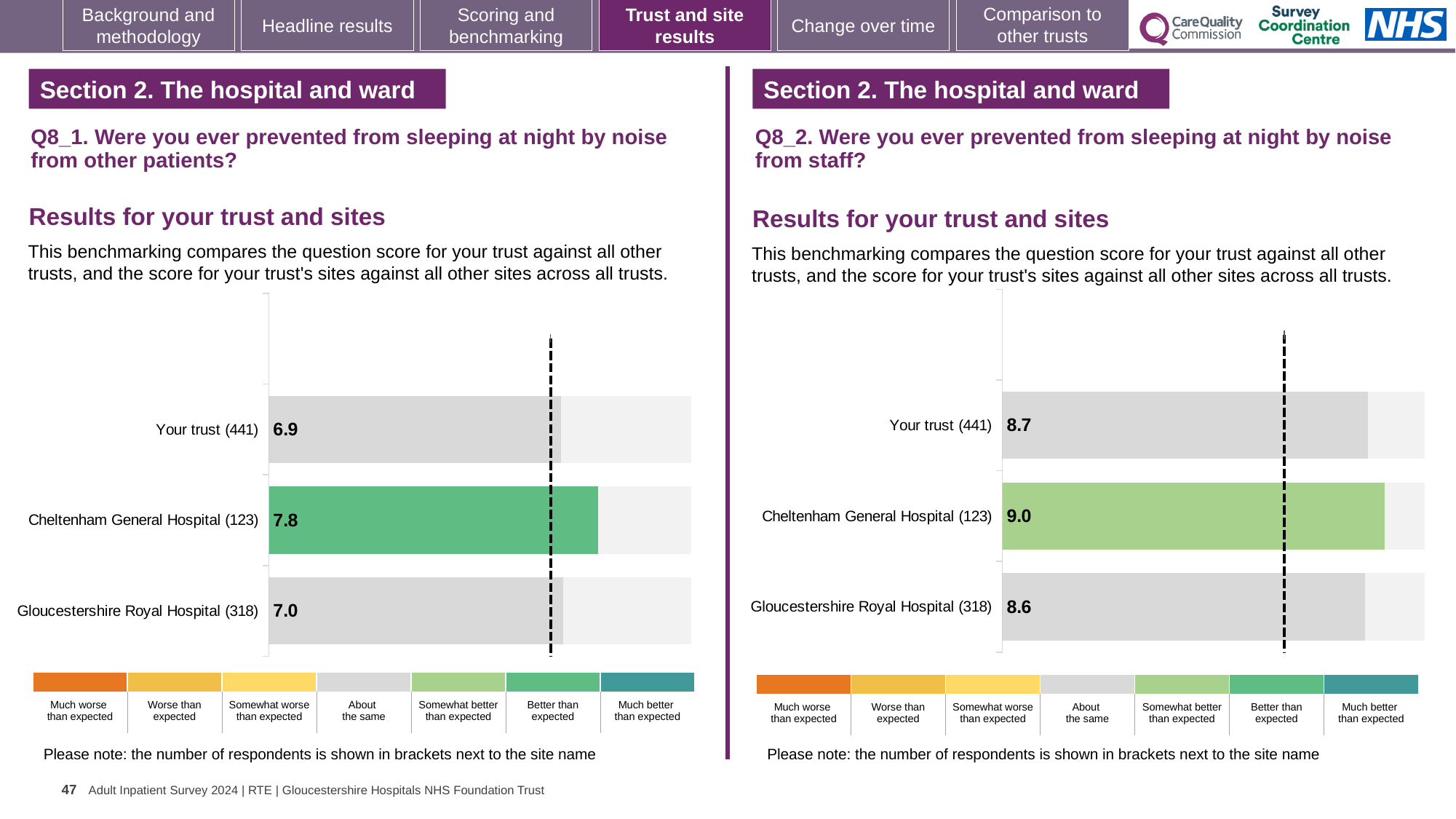
In the Q8_2 chart (noise from staff), which site or trust has the lowest score? Gloucestershire Royal Hospital In the Q8_1 chart (noise from other patients), what is the difference between the scores for Cheltenham General Hospital and Your trust? 0.9 In the Q8_2 chart (noise from staff), what is the score for Gloucestershire Royal Hospital? 8.6 In the Q8_1 chart (noise from other patients), what is the score for Your trust? 6.9 In the Q8_1 chart (noise from other patients), what is the score for Cheltenham General Hospital? 7.8 In the Q8_2 chart (noise from staff), which has the larger score, Cheltenham General Hospital or Gloucestershire Royal Hospital? Cheltenham General Hospital What type of chart is used for the Q8_2 results (noise from staff)? Bar chart In the Q8_1 chart (noise from other patients), what is the score for Gloucestershire Royal Hospital? 7.0 In the Q8_1 chart (noise from other patients), which site or trust has the highest score? Cheltenham General Hospital How many bars are plotted in the Q8_1 chart (noise from other patients)? 3 In the Q8_2 chart (noise from staff), what is the score for Cheltenham General Hospital? 9.0 In the Q8_2 chart (noise from staff), what is the score for Your trust? 8.7